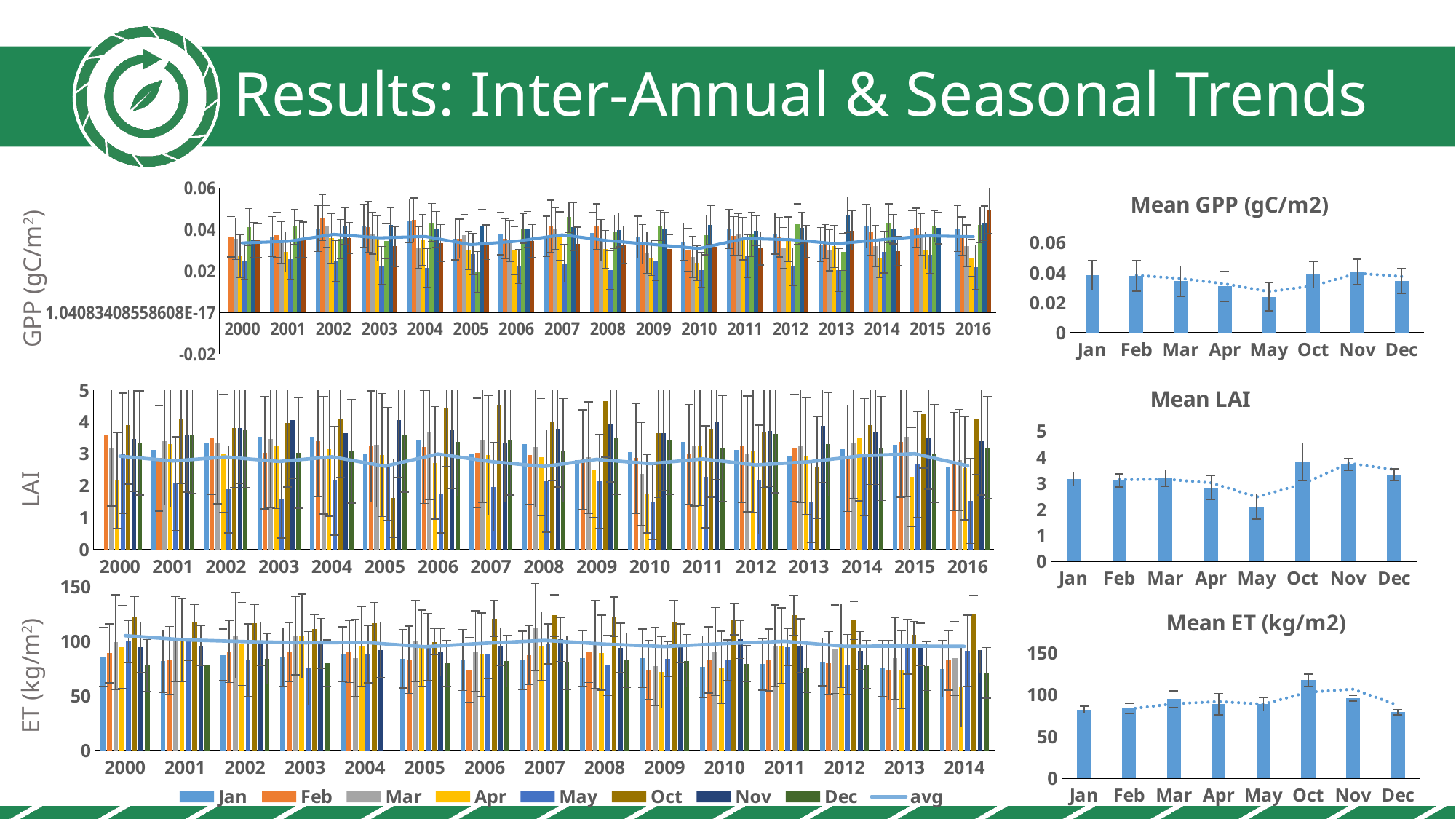
In the 'Mean LAI' chart, which is larger, the value for Oct or the value for May? Oct How many months are shown on the x axis of the 'Mean GPP (gC/m2)' chart? 8 In the 'Mean GPP (gC/m2)' chart, is the value for May greater or less than 0.04? less In the 'Mean ET (kg/m2)' chart, which month has the highest mean ET? Oct In the 'Mean GPP (gC/m2)' chart, which month has the lowest mean GPP? May In the 'Mean LAI' chart, is the value for May greater or less than 3? less How many entries does the legend at the bottom of the slide list? 9 What kind of chart is the 'Mean LAI' chart on the right of the slide? bar chart In the 'Mean ET (kg/m2)' chart, is the value for Oct greater or less than 100? greater In the 'Mean ET (kg/m2)' chart, do the values rise or fall from Oct to Dec? fall In the 'Mean LAI' chart, which month has the lowest mean LAI? May How many years are shown on the x axis of the large ET (kg/m²) chart on the left? 15